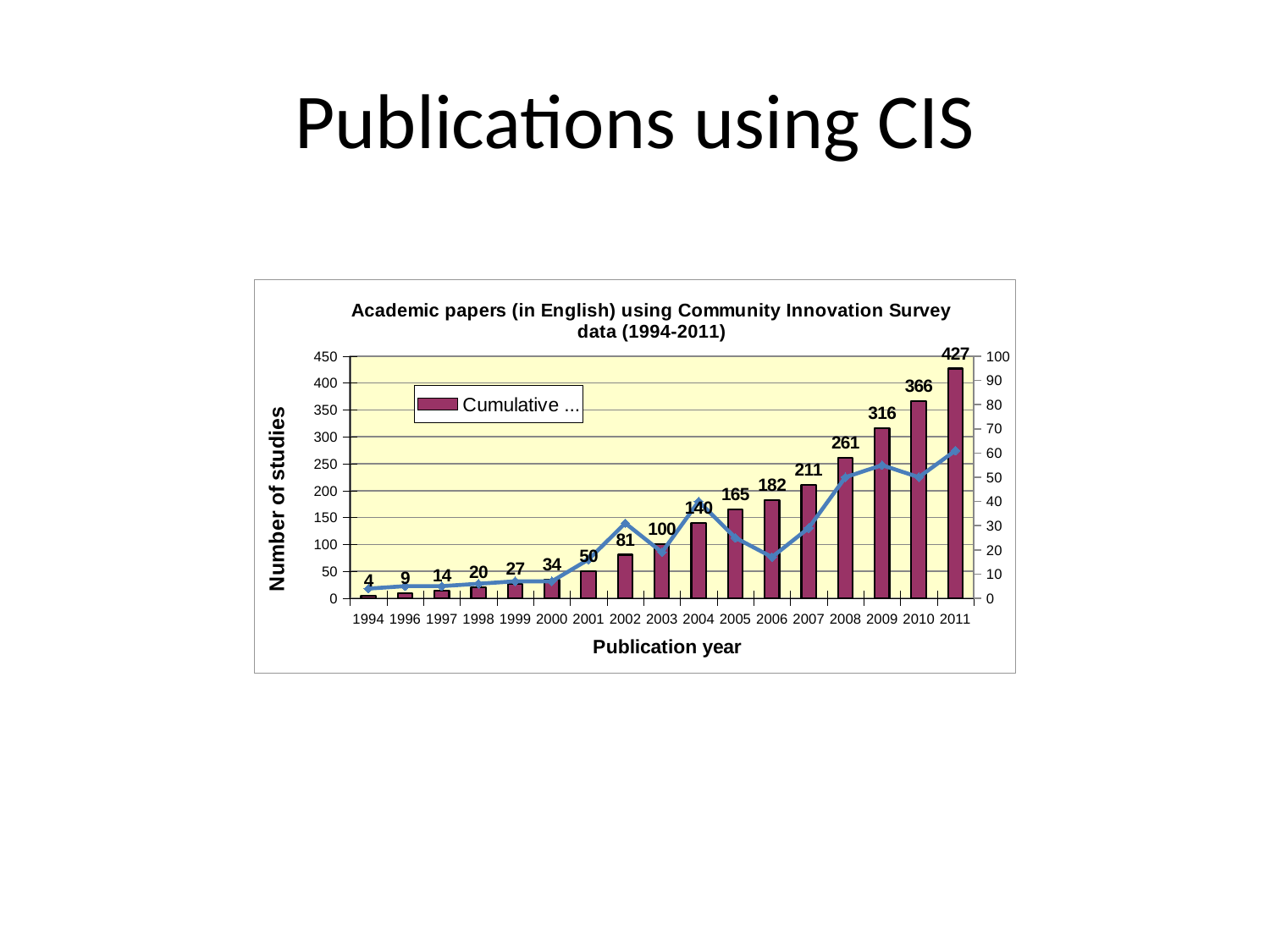
What is the cumulative number of studies shown for 2011? 427 How many publication years are shown on the x axis? 17 What value is labelled on the bar for 2000? 34 Do the bar values rise or fall from 1994 to 2011? Rise Is the line value for 2004 on the right-hand axis greater or less than 30? greater By how much does the bar value for 2011 exceed the bar value for 2010? 61 Which publication year has the shortest bar? 1994 What value is labelled on the bar for 2002? 81 What is the difference between the bar values for 2008 and 2007? 50 What kind of chart is this? Bar chart with a line series Which publication year has the tallest bar? 2011 Which year has the larger bar value, 2005 or 2006? 2006